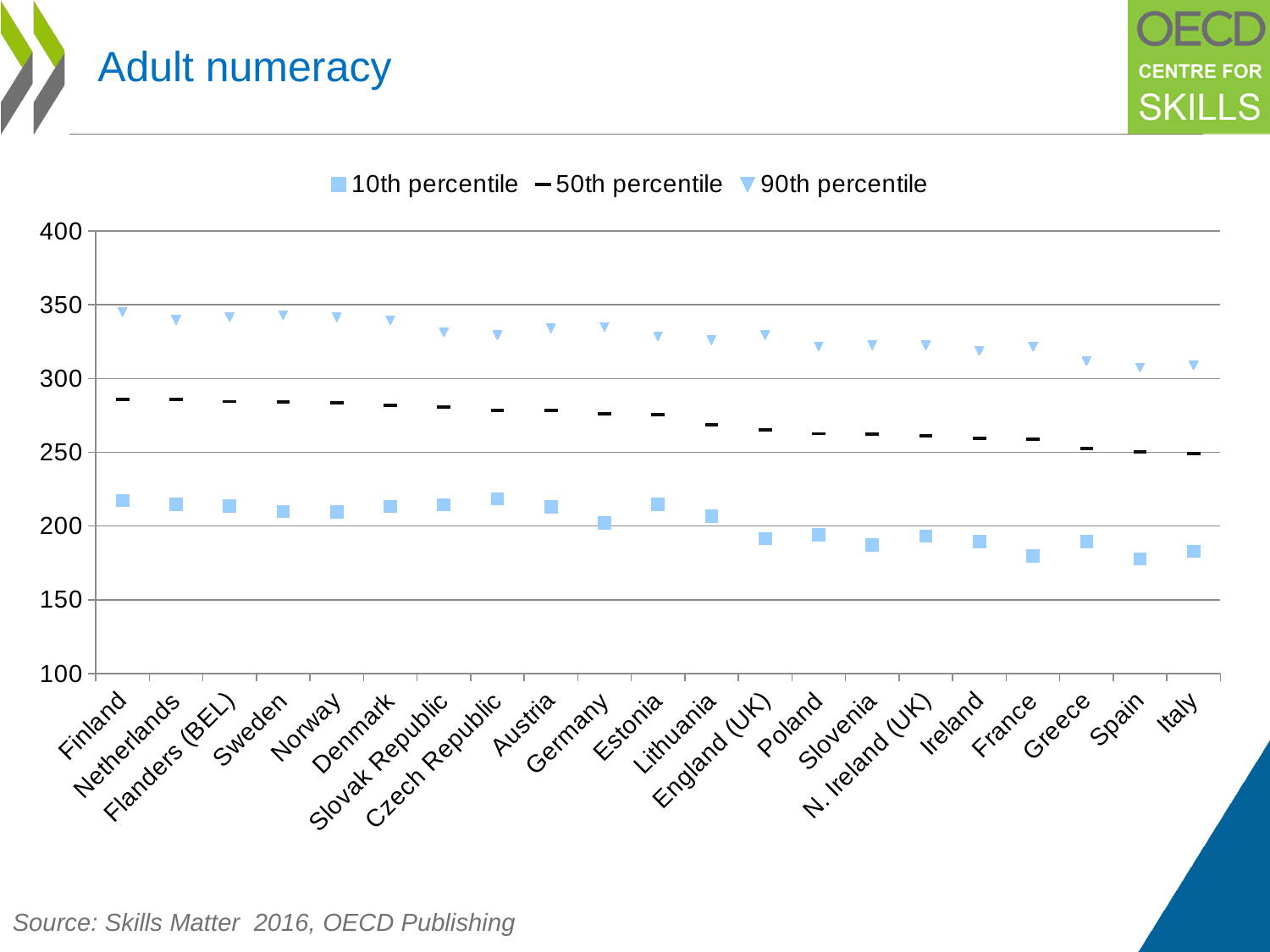
How many series does the legend list? 3 What is the title of the slide containing the chart? Adult numeracy Is the 50th percentile value for Italy greater or less than 300? less Is the 10th percentile value for Spain greater or less than 200? less Do the 50th percentile values rise or fall moving from Finland on the left to Italy on the right? fall Is the 10th percentile value for Finland greater or less than 200? greater Which has the higher 10th percentile value, Finland or Spain? Finland What kind of chart is this? scatter chart How many countries or regions are shown on the x axis? 21 Which has the higher 50th percentile value, Netherlands or Italy? Netherlands